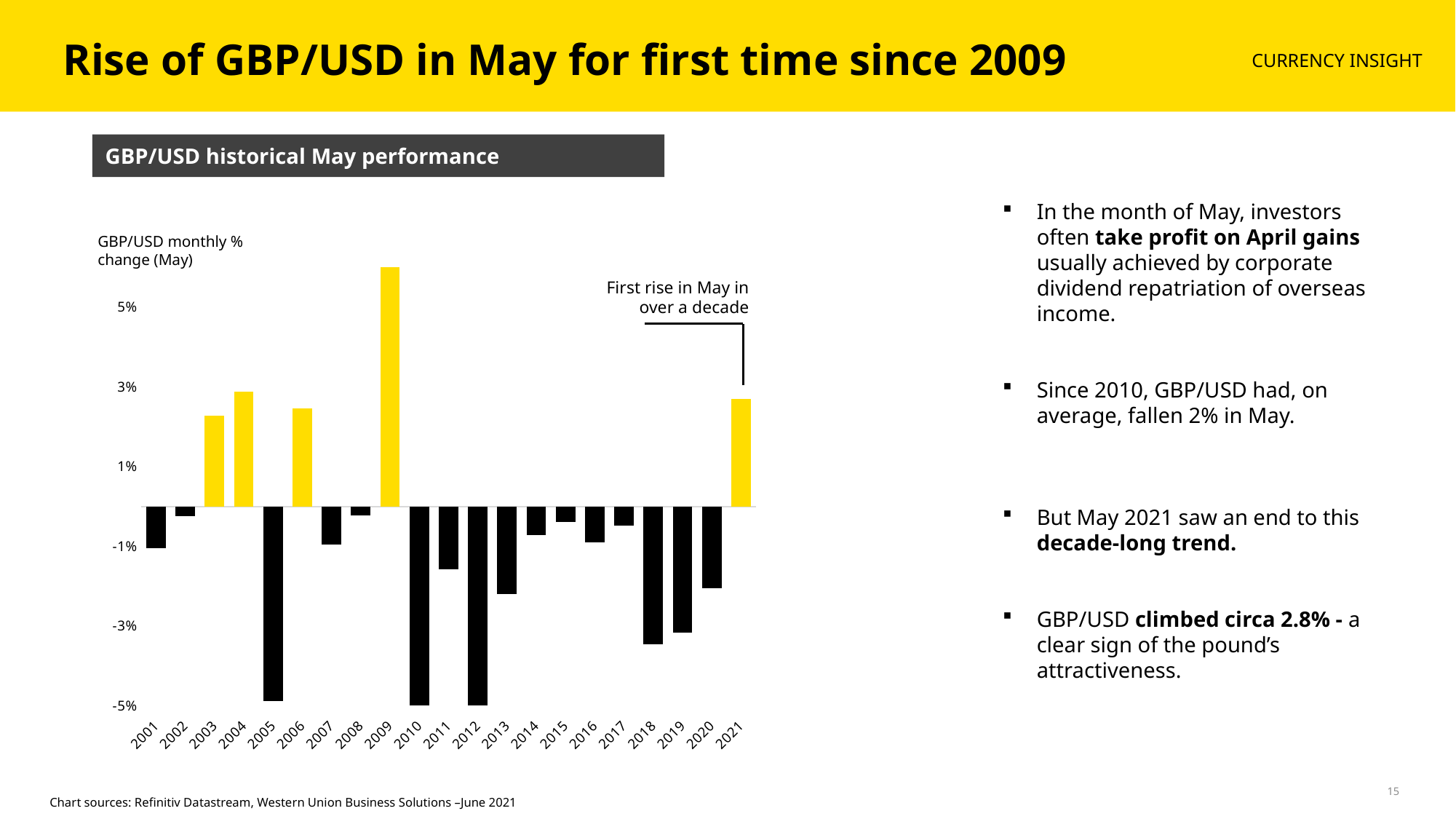
Is the value for 2005 greater or less than -3%? less Is the value for 2018 greater or less than -3%? less What does the annotation pointing to the 2021 bar say? First rise in May in over a decade Is the value for 2021 greater or less than 1%? greater Which year has the larger May % change, 2004 or 2003? 2004 Which year has the larger May % change, 2009 or 2021? 2009 What kind of chart is shown on the slide? Bar chart What is the title of the chart? GBP/USD historical May performance Which year has the highest GBP/USD May % change in the chart? 2009 How many years are plotted on the x axis of the chart? 21